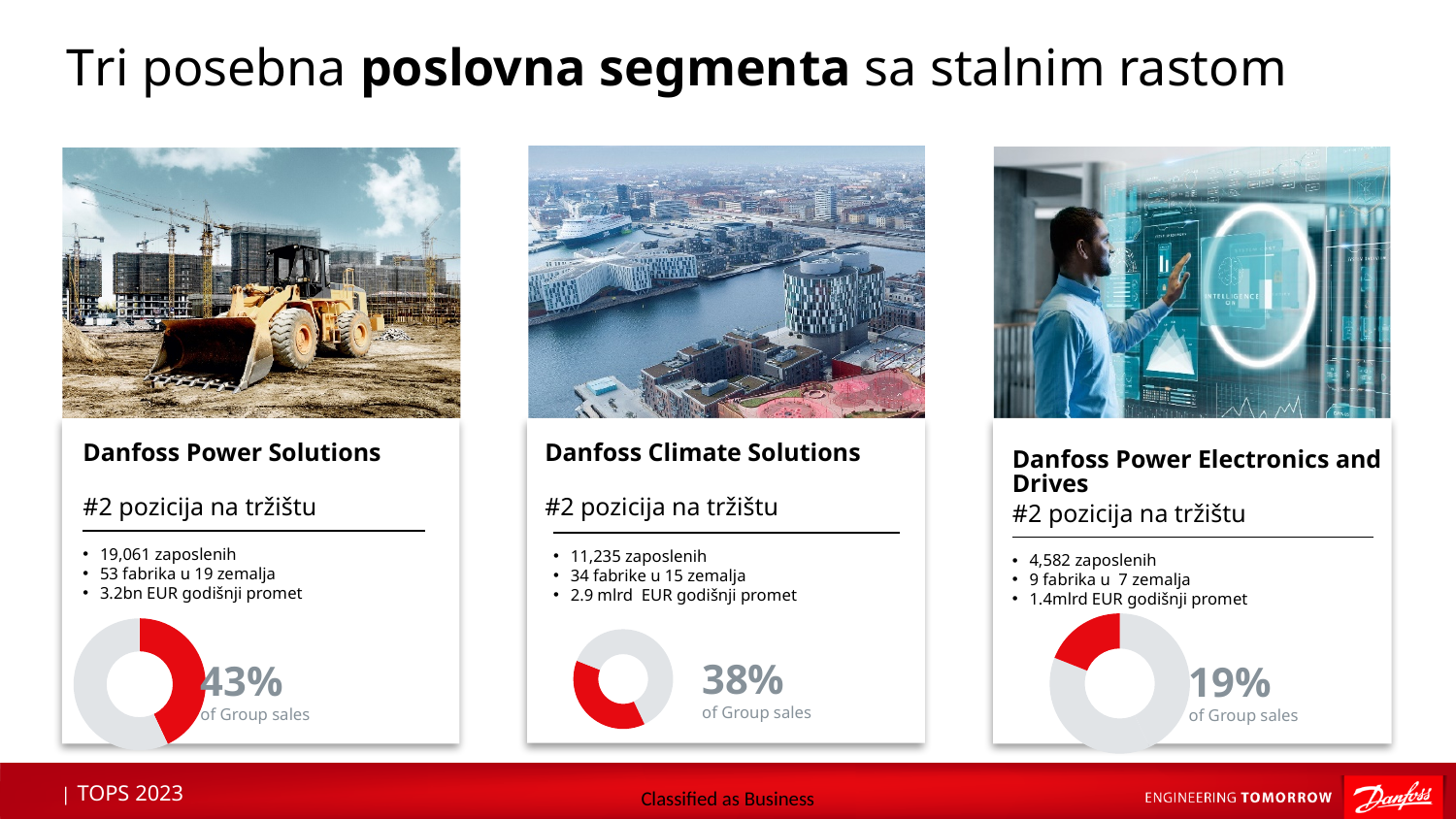
How many donut charts are shown on the slide? 3 What is the difference in percentage points between the Group sales share of Danfoss Power Solutions and Danfoss Climate Solutions? 5% Which of the three business segments has the highest share of Group sales according to the donut charts? Danfoss Power Solutions What is the difference in percentage points between the Group sales share of Danfoss Power Solutions and Danfoss Power Electronics and Drives? 24% What share of Group sales does the donut chart under Danfoss Climate Solutions show? 38% What share of Group sales does the donut chart under Danfoss Power Electronics and Drives show? 19% Which of the three business segments has the lowest share of Group sales according to the donut charts? Danfoss Power Electronics and Drives What colour is the highlighted slice in each donut chart? Red In the donut chart under Danfoss Climate Solutions, is the share of Group sales greater or less than 50%? less Which segment has a larger share of Group sales: Danfoss Climate Solutions or Danfoss Power Electronics and Drives? Danfoss Climate Solutions What share of Group sales does the donut chart under Danfoss Power Solutions show? 43% What type of chart is used to show each segment's share of Group sales? Donut (pie) chart